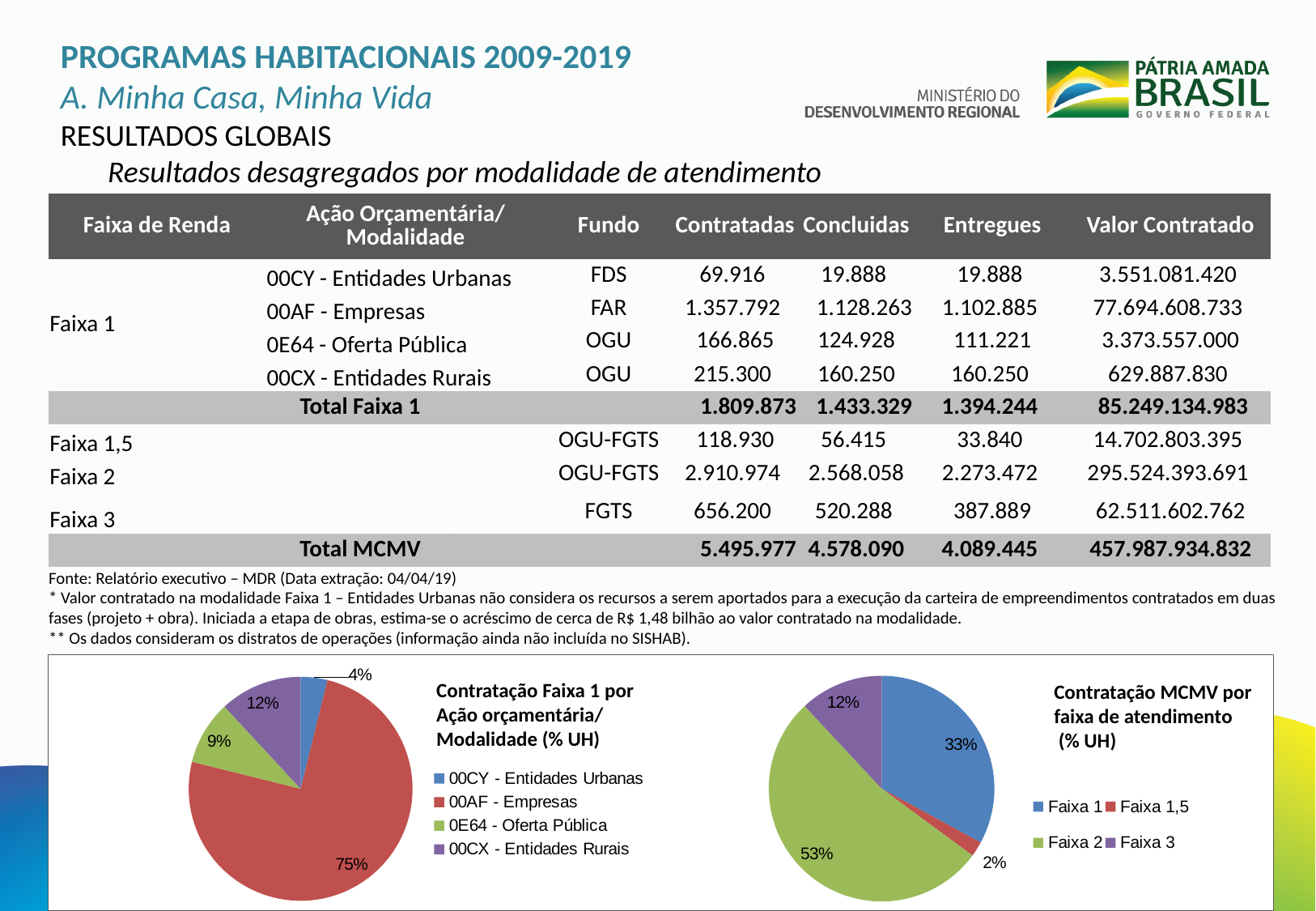
In the left pie chart (Contratação Faixa 1 por Ação orçamentária/Modalidade), what share does 00AF - Empresas have? 75% In the right pie chart (Contratação MCMV por faixa de atendimento), what share does Faixa 1,5 have? 2% In the right pie chart (Contratação MCMV por faixa de atendimento), which faixa has the largest share? Faixa 2 In the right pie chart (Contratação MCMV por faixa de atendimento), what colour is the Faixa 2 slice? Green In the right pie chart (Contratação MCMV por faixa de atendimento), what share does Faixa 2 have? 53% In the left pie chart (Contratação Faixa 1 por Ação orçamentária/Modalidade), what is the difference in percentage points between 00AF - Empresas and 0E64 - Oferta Pública? 66 In the left pie chart (Contratação Faixa 1 por Ação orçamentária/Modalidade), how many slices are there? 4 In the right pie chart (Contratação MCMV por faixa de atendimento), which is larger, Faixa 1 or Faixa 3? Faixa 1 In the left pie chart (Contratação Faixa 1 por Ação orçamentária/Modalidade), which modality has the largest share? 00AF - Empresas In the left pie chart (Contratação Faixa 1 por Ação orçamentária/Modalidade), which modality has the smallest share? 00CY - Entidades Urbanas What type of chart is the right chart (Contratação MCMV por faixa de atendimento)? Pie chart